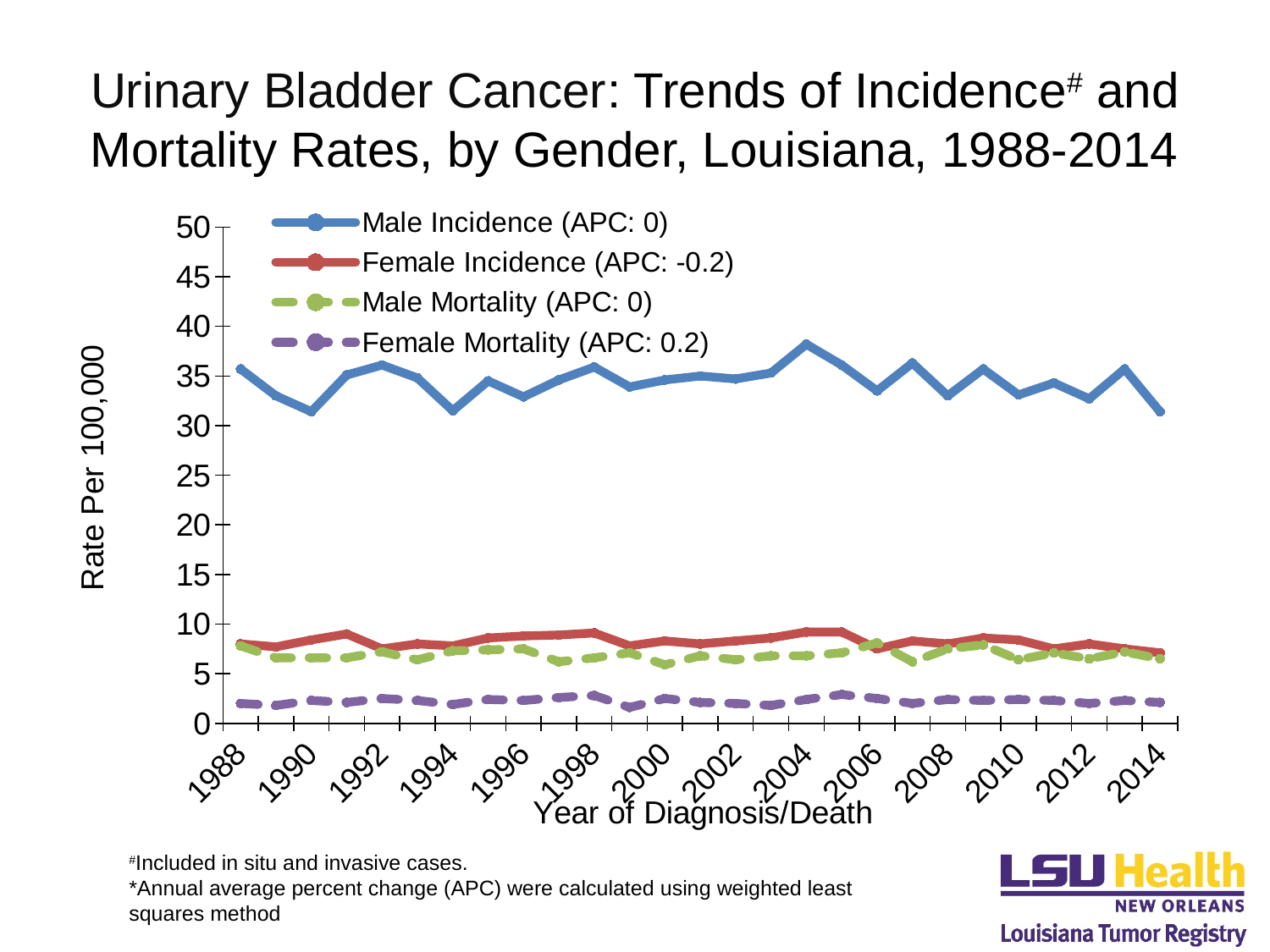
Is the Female Incidence rate in 1991 greater or less than 10? less What kind of chart is shown on the slide? Line chart Is the Male Incidence rate in 1990 greater or less than 35? less In 2000, which is larger: Male Incidence or Female Incidence? Male Incidence Is the Male Incidence rate in 2005 greater or less than 35? greater What APC value does the legend give for Female Incidence? -0.2 Which series has the highest values throughout the chart? Male Incidence What is the label of the y axis? Rate Per 100,000 How many years are plotted along the x axis, from 1988 to 2014? 27 How many series does the legend list? 4 Which series has the lowest values throughout the chart? Female Mortality